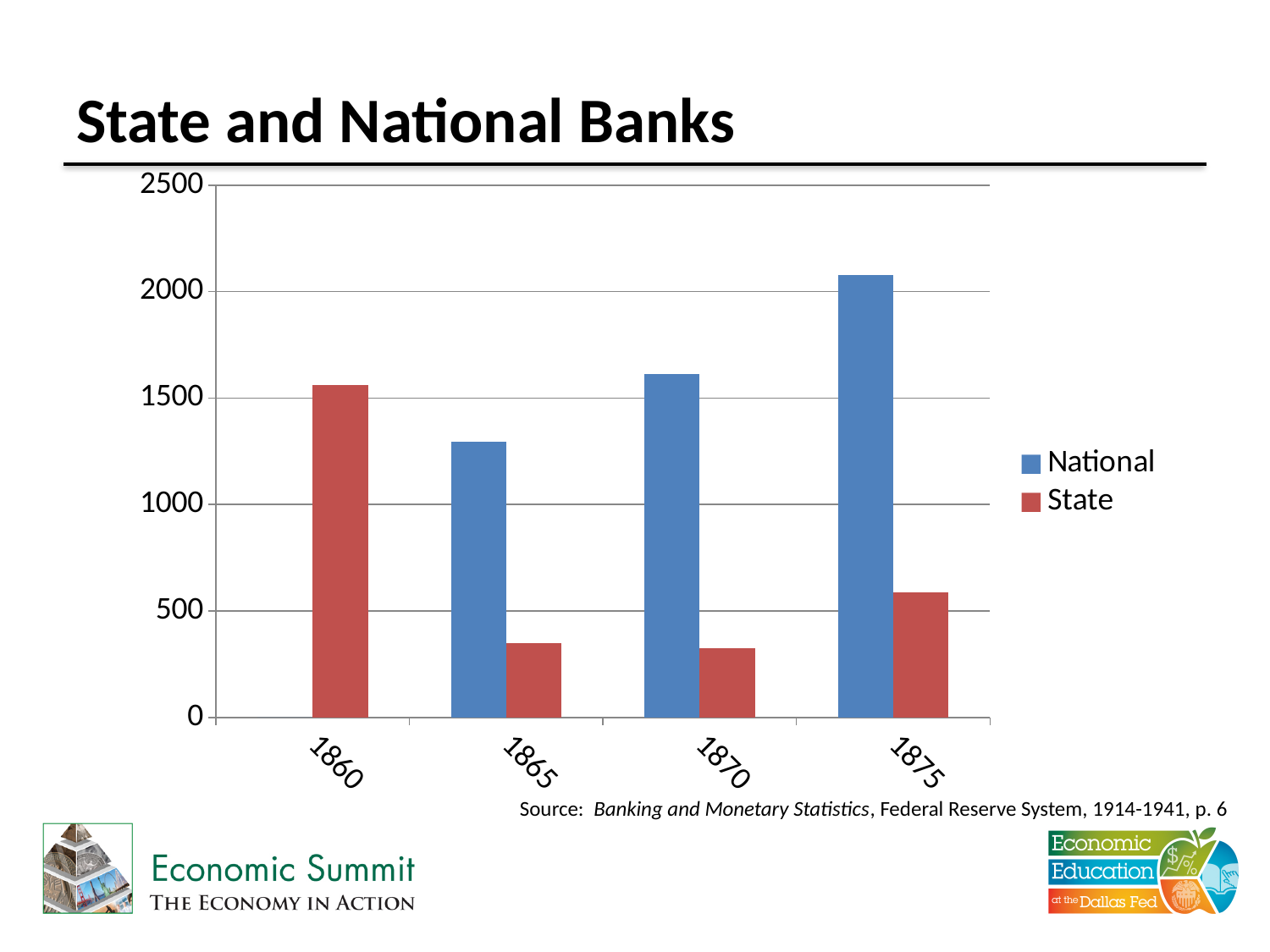
In which year is the State series highest? 1860 Is the value for National in 1865 greater or less than 1500? less Is the value for National in 1875 greater or less than 2000? greater How many series does the legend list? 2 What is the title of the chart? State and National Banks What kind of chart is shown on the slide? bar chart Do the National values rise or fall from 1865 to 1875? rise Is the value for State in 1860 greater or less than 1500? greater How many years are shown on the x axis? 4 In 1875, which is larger, National or State? National In which year is the National series highest? 1875